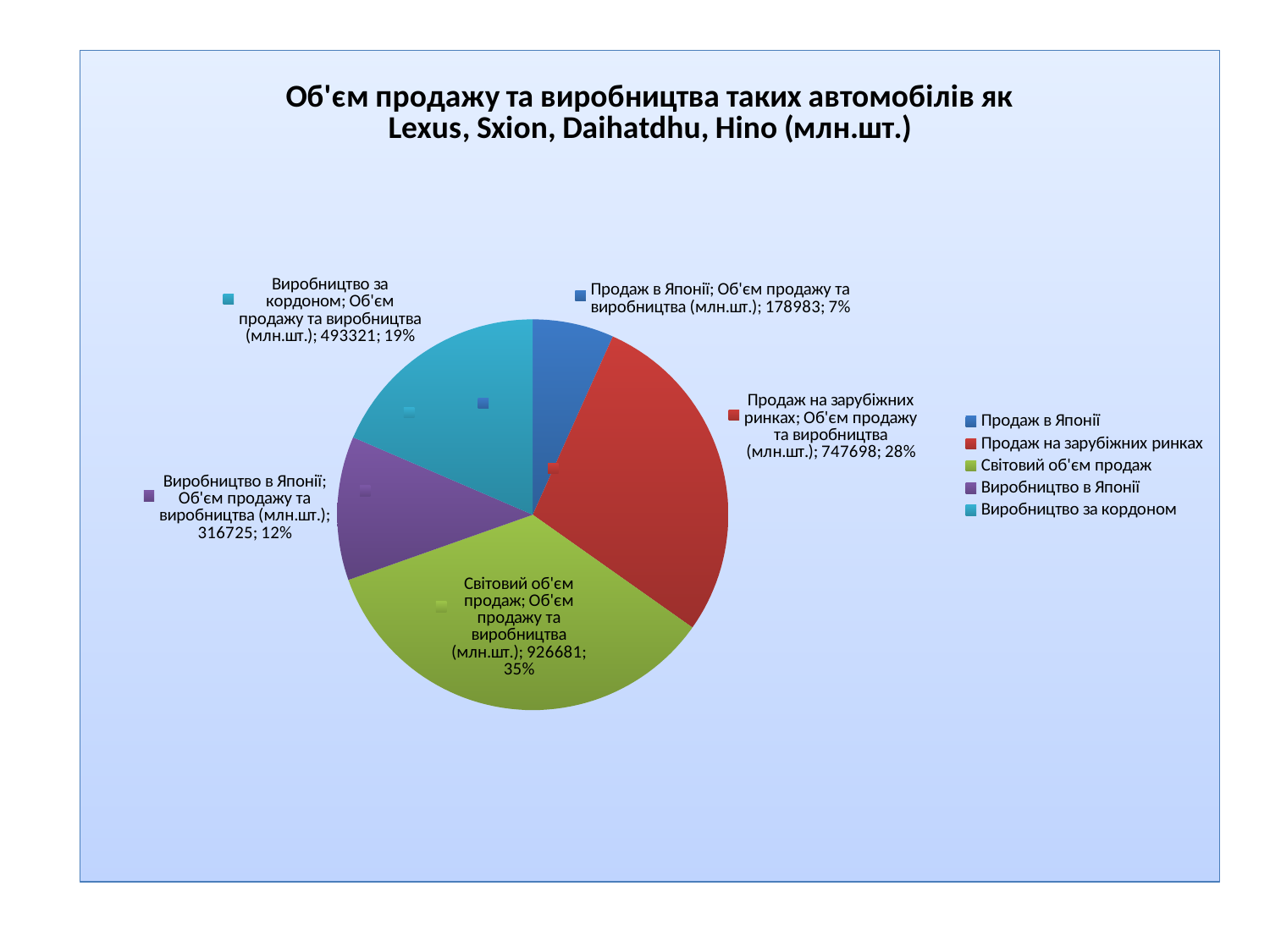
Which category has the largest slice of the pie? Світовий об'єм продаж What type of chart is shown on the slide? pie chart What is the value for Виробництво за кордоном? 493321 What is the value for Виробництво в Японії? 316725 Which is larger, Виробництво в Японії or Виробництво за кордоном? Виробництво за кордоном Which category has the smallest slice of the pie? Продаж в Японії What is the difference between the values for Світовий об'єм продаж and Продаж на зарубіжних ринках? 178983 What share of the pie does Виробництво за кордоном represent? 19% What is the value for Продаж на зарубіжних ринках? 747698 How many categories does the legend list? 5 What is the value for Світовий об'єм продаж? 926681 What is the value for Продаж в Японії? 178983